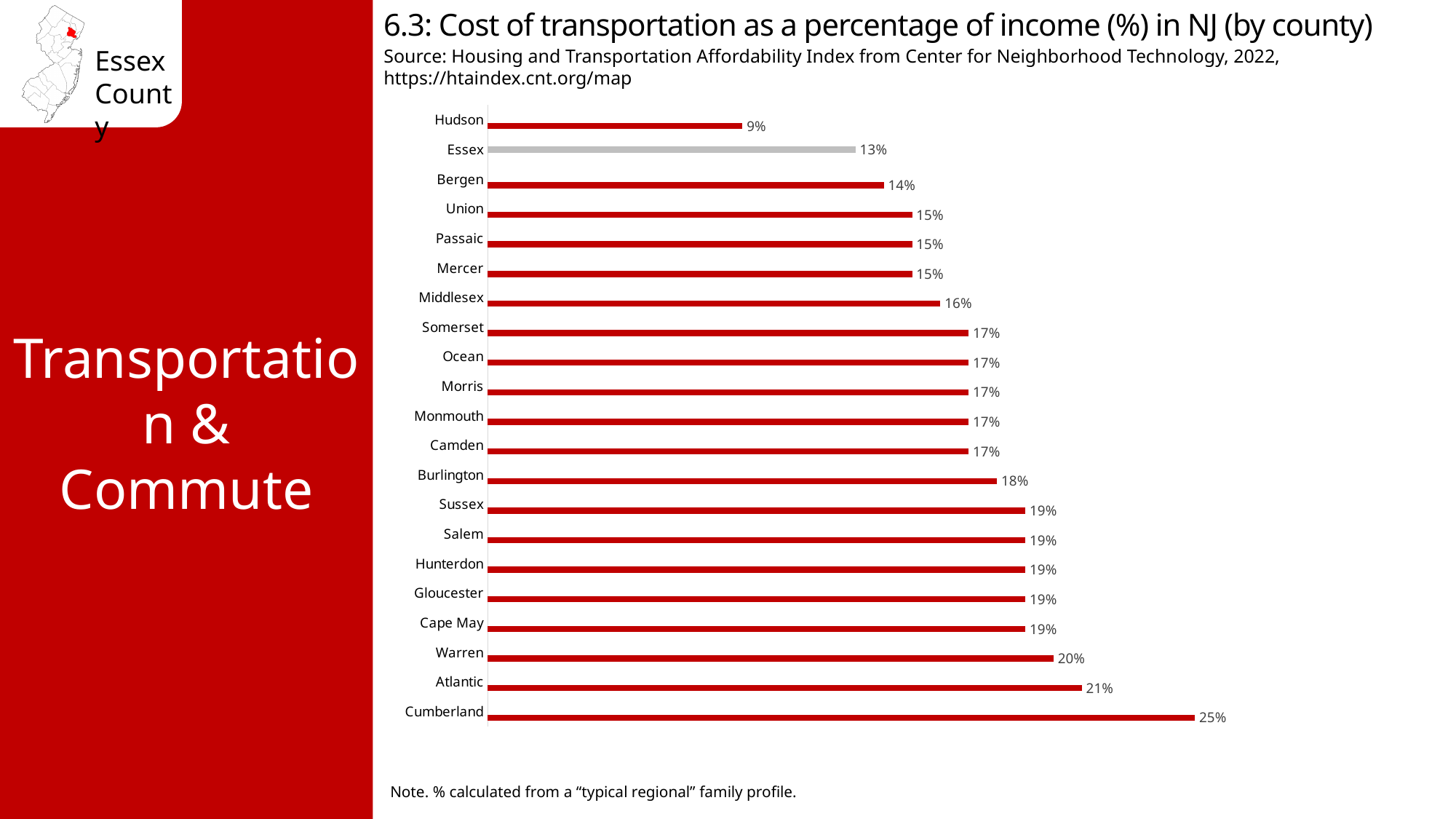
What is the difference between the values for Cumberland and Essex? 12% What is the value shown for Hudson County? 9% What is the cost of transportation as a percentage of income for Essex County? 13% What is the value shown for Burlington County? 18% What is the difference between the values for Atlantic and Hudson? 12% What kind of chart is shown on the slide? Bar chart Which county's bar is shown in grey rather than red? Essex How many counties are shown in the chart? 21 Which county has the highest cost of transportation as a percentage of income? Cumberland Which has a higher value, Bergen or Warren? Warren Which county has the lowest cost of transportation as a percentage of income? Hudson What is the cost of transportation as a percentage of income for Cumberland County? 25%